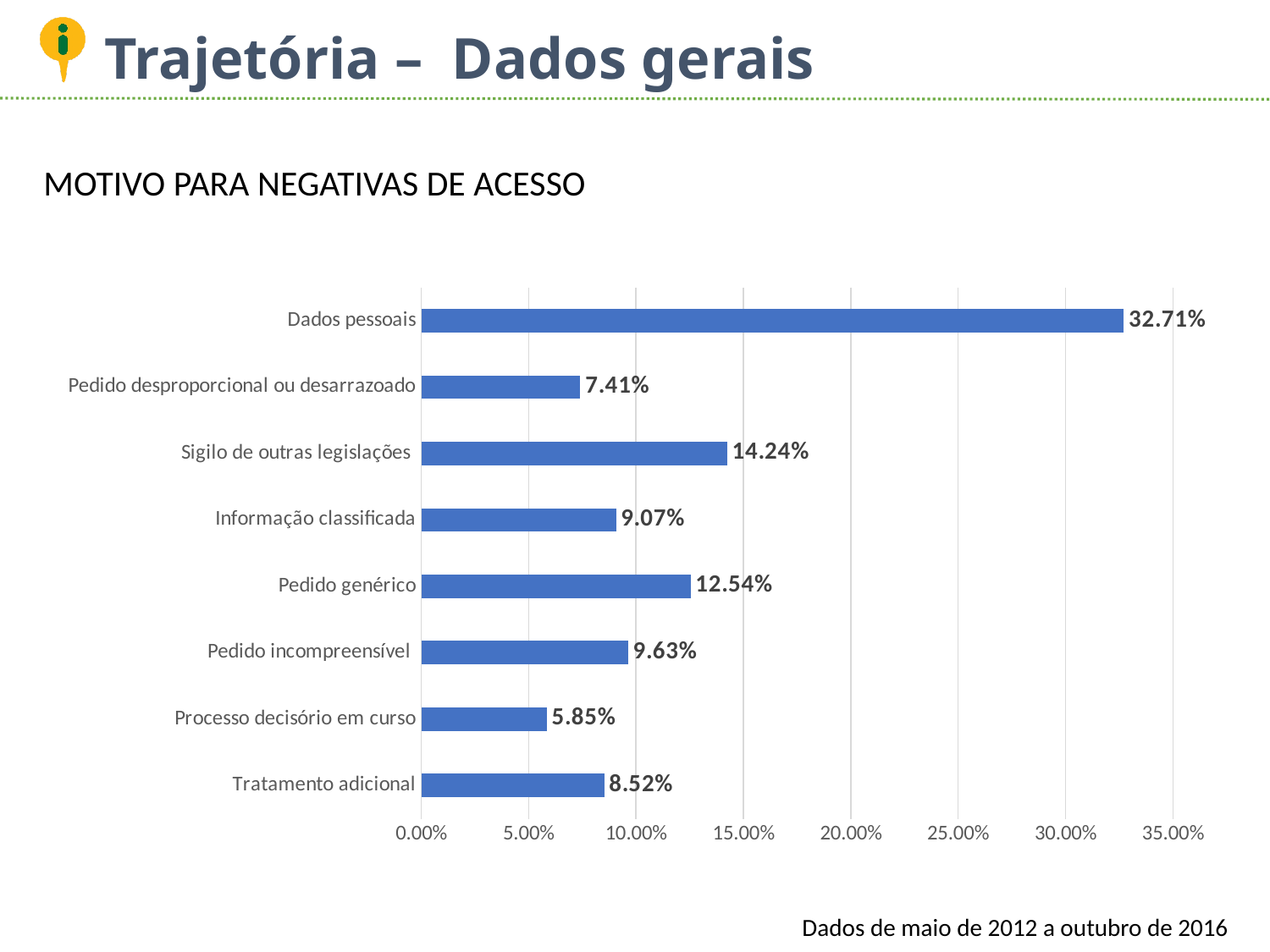
What is the title of the chart? MOTIVO PARA NEGATIVAS DE ACESSO Is the value for Pedido incompreensível greater or less than 10.00%? less Which is larger, Pedido genérico or Informação classificada? Pedido genérico How many categories are shown in the chart? 8 What is the value for Processo decisório em curso? 5.85% What kind of chart is shown on the slide? bar chart Which category has the lowest value? Processo decisório em curso What is the value for Tratamento adicional? 8.52% What is the value for Sigilo de outras legislações? 14.24% What is the value for Dados pessoais? 32.71% Which category has the highest value? Dados pessoais What is the difference between Dados pessoais and Sigilo de outras legislações? 18.47%